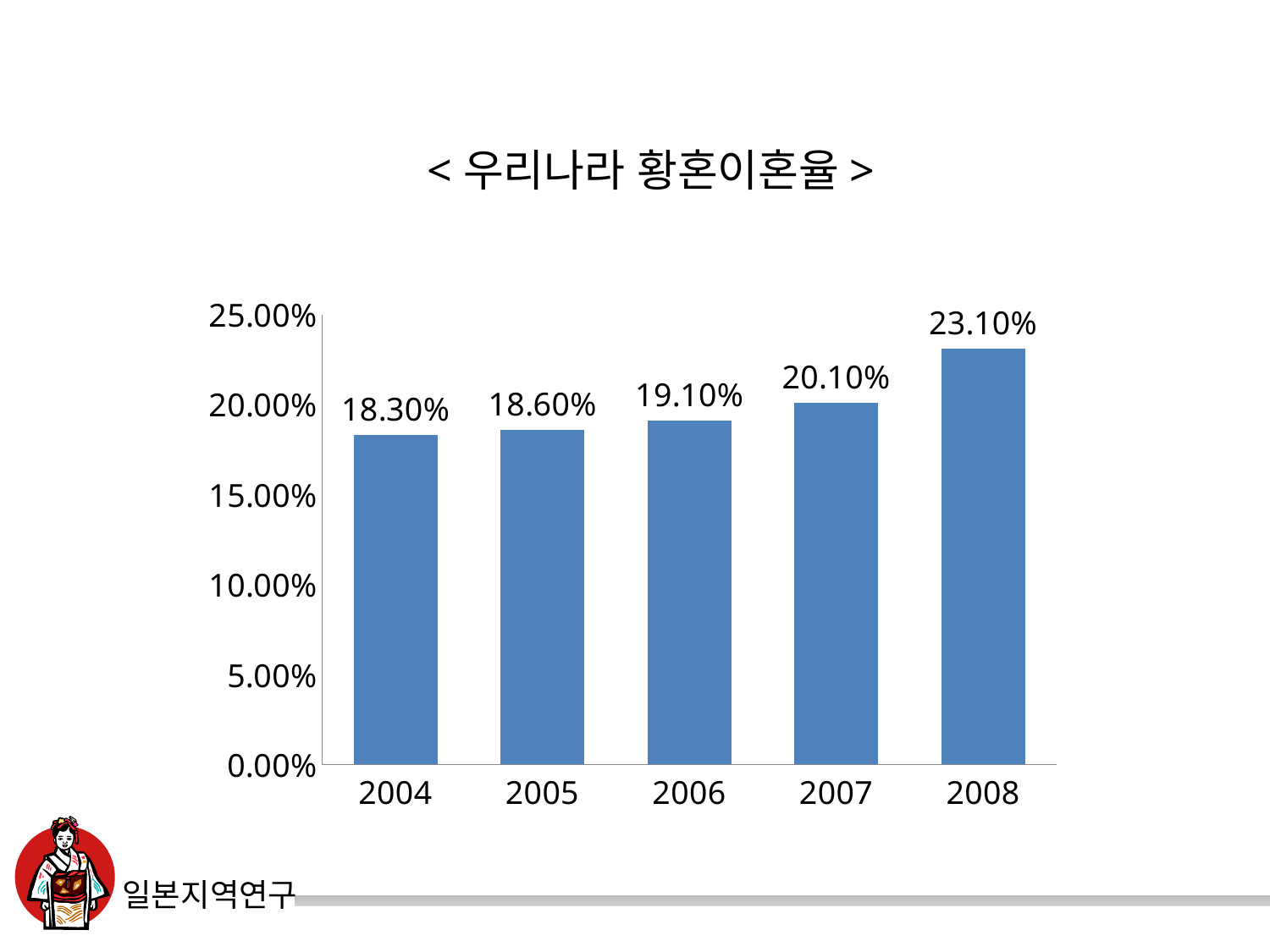
Which is larger, the value for 2007 or the value for 2005? 2007 What is the value for 2004? 18.30% How many years are shown on the x axis? 5 What is the value for 2008? 23.10% What is the difference between the values for 2008 and 2007? 3.00% Do the values rise or fall from 2004 to 2008? rise Which year has the highest value? 2008 Which year has the lowest value? 2004 What kind of chart is shown on the slide? bar chart What is the difference between the values for 2005 and 2004? 0.30% Is the value for 2006 greater or less than 20.00%? less What is the value for 2006? 19.10%